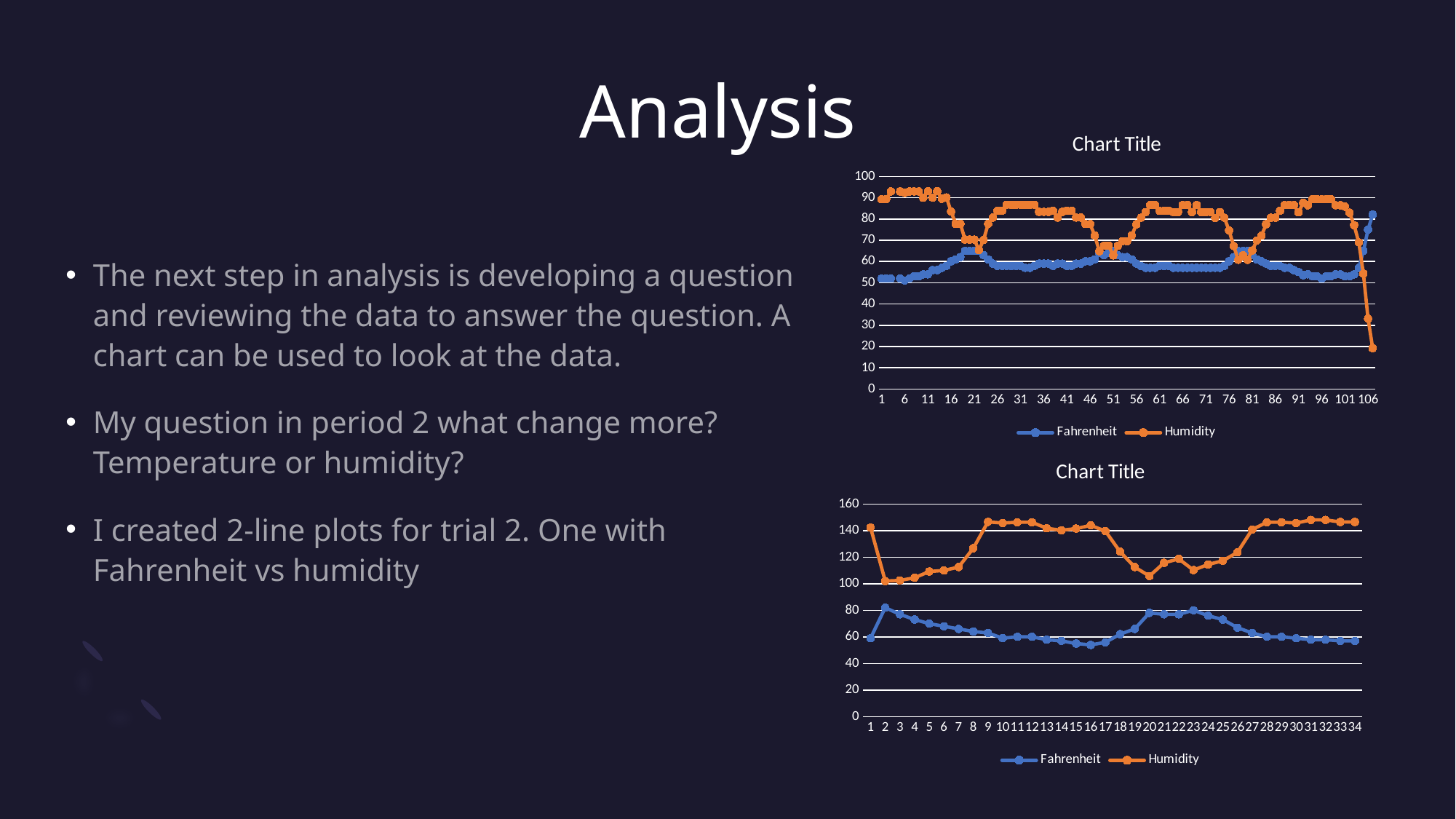
In the top chart, which series has the larger value at point 106, Fahrenheit or Humidity? Fahrenheit In the bottom chart, is the Humidity value at point 2 greater or less than 120? less How many points are plotted along the x axis of the bottom chart? 34 How many series does the legend of the bottom chart list? 2 In the bottom chart, which series has the larger value at point 1, Fahrenheit or Humidity? Humidity In the top chart, is the Humidity value at point 106 greater or less than 40? less In the top chart, is the Humidity value at point 1 greater or less than 80? greater What kind of chart is the top chart on the slide? line chart In the bottom chart, does the Humidity series rise or fall from point 2 to point 9? rise